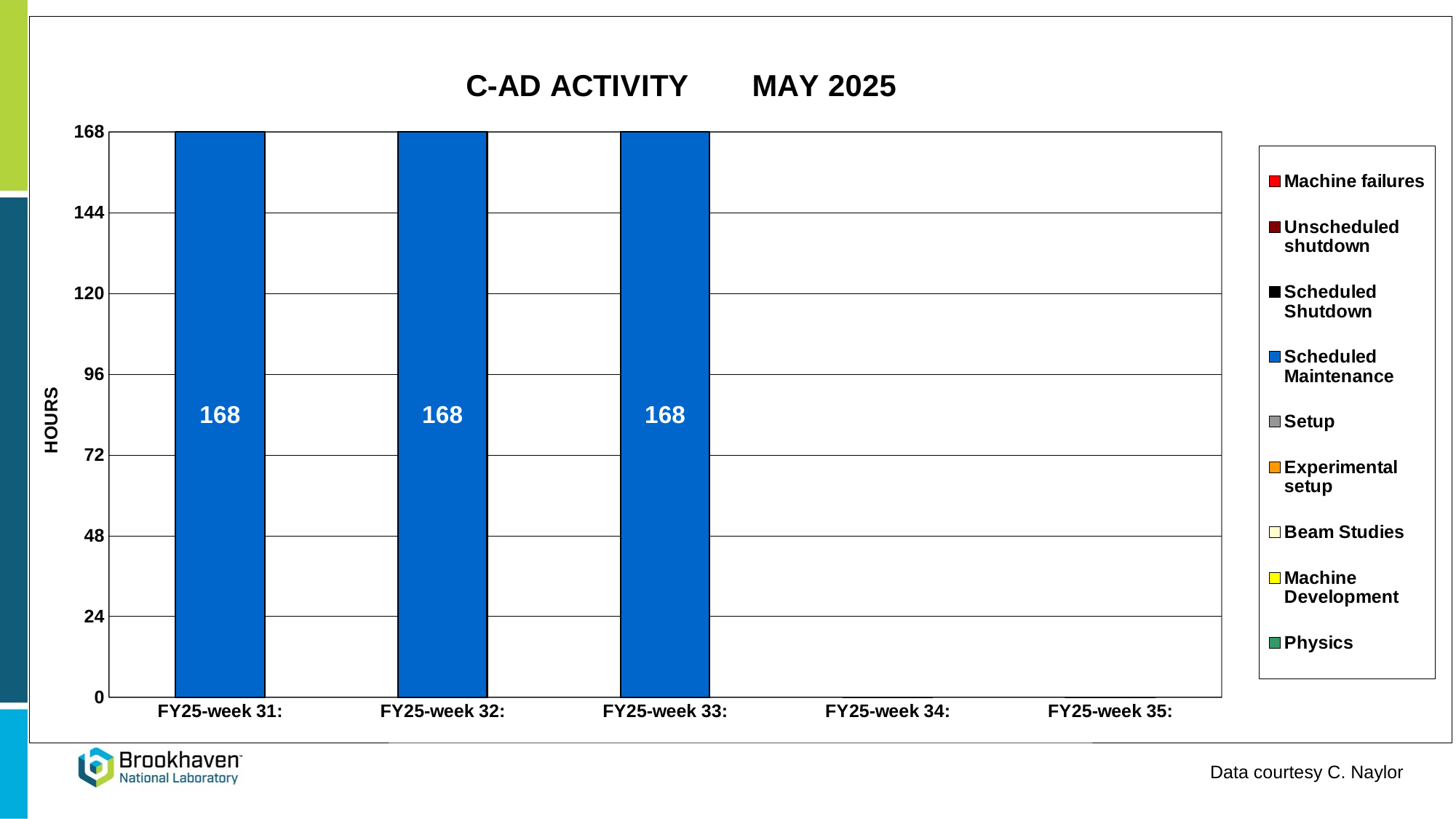
What is the label on the y axis? HOURS What is the value of the bar for FY25-week 31? 168 What is the difference between the values for FY25-week 32 and FY25-week 31? 0 Which legend series do the plotted bars for FY25-week 31 to FY25-week 33 belong to? Scheduled Maintenance How many categories are shown on the x axis? 5 What is the value of the bar for FY25-week 33? 168 How many series does the legend list? 9 Do the values for FY25-week 31, FY25-week 32 and FY25-week 33 rise, fall, or stay the same? stay the same What type of chart is shown on the slide? bar chart What is the title of the chart? C-AD ACTIVITY MAY 2025 Which categories have no bar plotted? FY25-week 34 and FY25-week 35 Is the value for FY25-week 32 greater or less than 144? greater